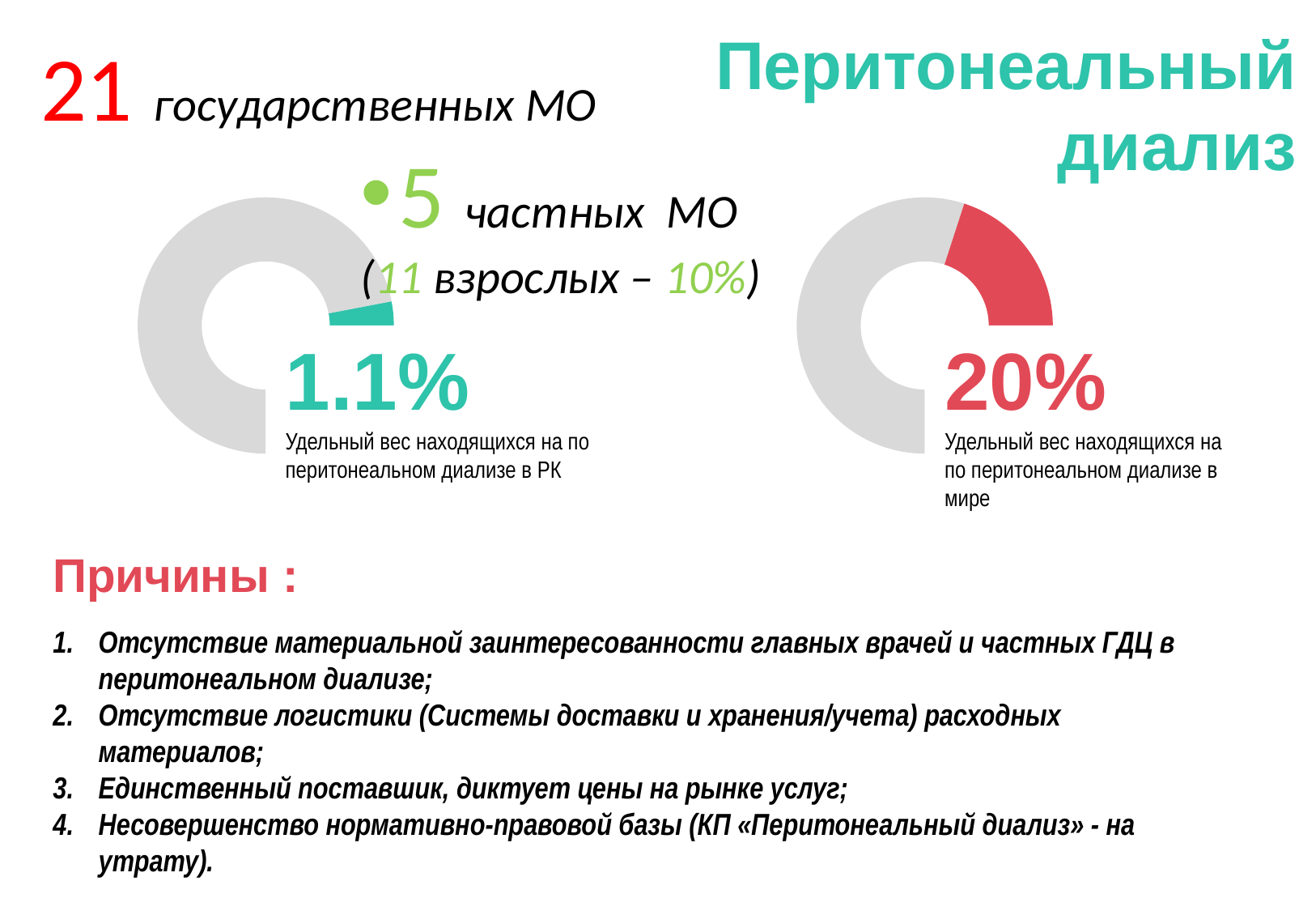
Which is larger: the share on peritoneal dialysis in the RK (left chart) or in the world (right chart)? In the world (20%) In the left donut chart, what share of the donut is not on peritoneal dialysis in the RK (the grey part)? 98.9% In the right donut chart, what share of the donut is not on peritoneal dialysis in the world (the grey part)? 80% How many donut charts are shown on the slide? 2 What kind of chart is used on the left side of the slide to show the share of patients on peritoneal dialysis in the RK? Donut (pie) chart In the left donut chart, what is the share of patients on peritoneal dialysis in the RK? 1.1% What is the difference between the world share (right chart, 20%) and the RK share (left chart, 1.1%) of patients on peritoneal dialysis? 18.9% What colour is the highlighted slice in the left donut chart showing the RK share? Teal (green) In the right donut chart, is the highlighted share of patients on peritoneal dialysis in the world greater or less than 50%? less What colour is the highlighted slice in the right donut chart showing the world share? Red In the left donut chart, is the highlighted share of patients on peritoneal dialysis in the RK greater or less than 10%? less In the right donut chart, what is the share of patients on peritoneal dialysis in the world? 20%